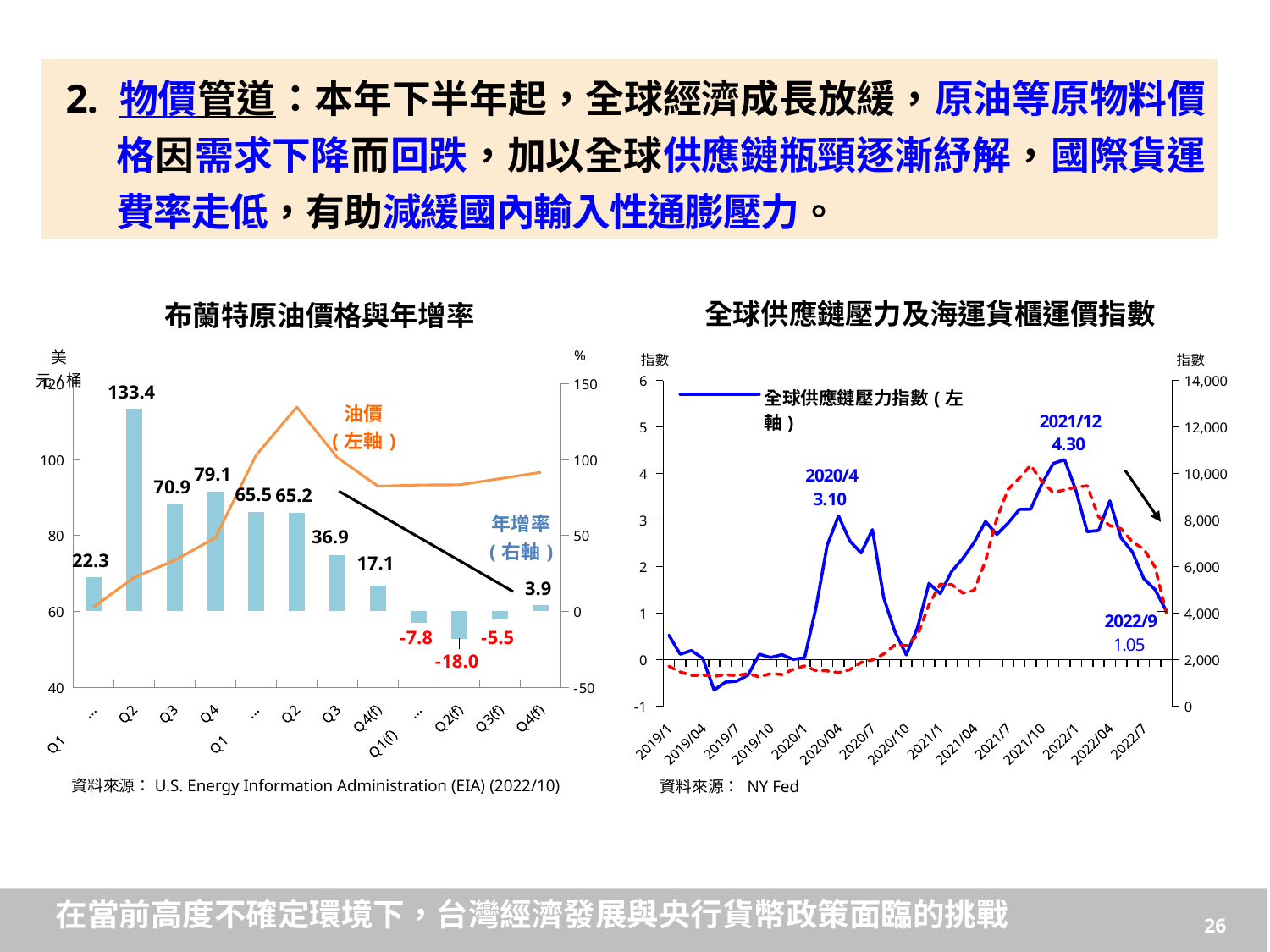
In the left chart (布蘭特原油價格與年增率), what is the value of the highest bar? 133.4 In the right chart (全球供應鏈壓力及海運貨櫃運價指數), what is the labelled value of the 全球供應鏈壓力指數 at 2021/12? 4.30 In the right chart (全球供應鏈壓力及海運貨櫃運價指數), does the 全球供應鏈壓力指數 rise or fall from 2021/12 to 2022/9? Fall In the left chart (布蘭特原油價格與年增率), how many bars are plotted? 12 In the left chart (布蘭特原油價格與年增率), what is the value of the lowest bar? -18.0 What kind of chart is the left chart titled 布蘭特原油價格與年增率? A combined bar and line chart In the left chart (布蘭特原油價格與年增率), which series is plotted on the left axis? 油價 In the right chart (全球供應鏈壓力及海運貨櫃運價指數), what is the labelled value of the 全球供應鏈壓力指數 at 2020/4? 3.10 In the right chart (全球供應鏈壓力及海運貨櫃運價指數), what is the labelled value of the 全球供應鏈壓力指數 at 2022/9? 1.05 In the left chart (布蘭特原油價格與年增率), what is the difference between the highest bar (133.4) and the bar labelled 70.9? 62.5 In the right chart (全球供應鏈壓力及海運貨櫃運價指數), what is the difference between the 全球供應鏈壓力指數 values at 2021/12 and 2022/9? 3.25 In the left chart (布蘭特原油價格與年增率), what is the value of the last bar, for Q4(f)? 3.9